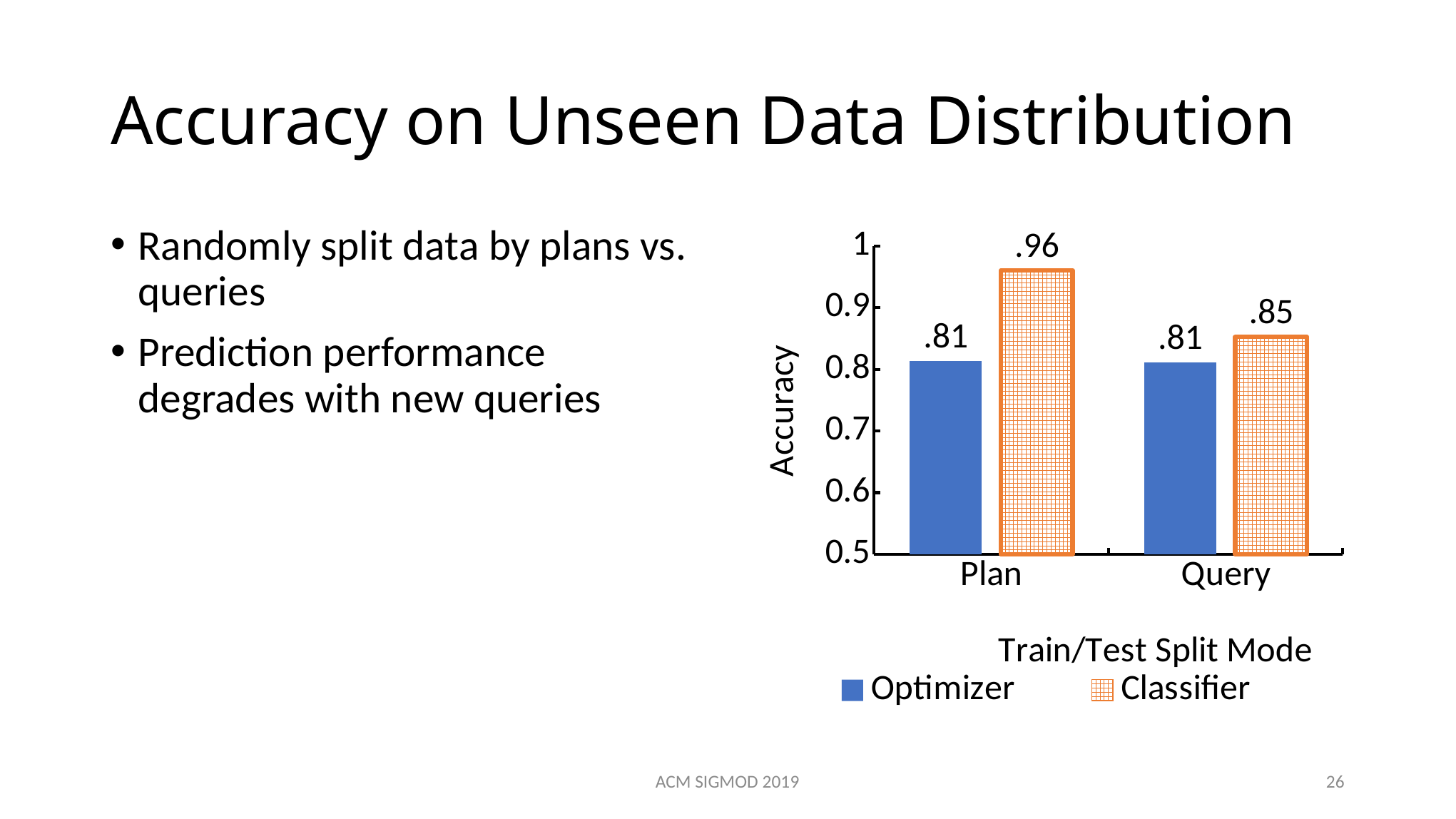
What is the label of the x axis of the chart? Train/Test Split Mode What is the accuracy of the Classifier for the Plan split mode? .96 What is the accuracy of the Optimizer for the Plan split mode? .81 What is the accuracy of the Optimizer for the Query split mode? .81 Which split mode has the highest Classifier accuracy? Plan How many split modes are shown on the x axis? 2 What is the difference between the Classifier accuracy for Plan and for Query? .11 For the Query split mode, which has higher accuracy, the Optimizer or the Classifier? Classifier What is the difference between the Classifier and Optimizer accuracy for the Plan split mode? .15 What kind of chart is shown on the slide? Bar chart How many series does the legend list? 2 What is the accuracy of the Classifier for the Query split mode? .85